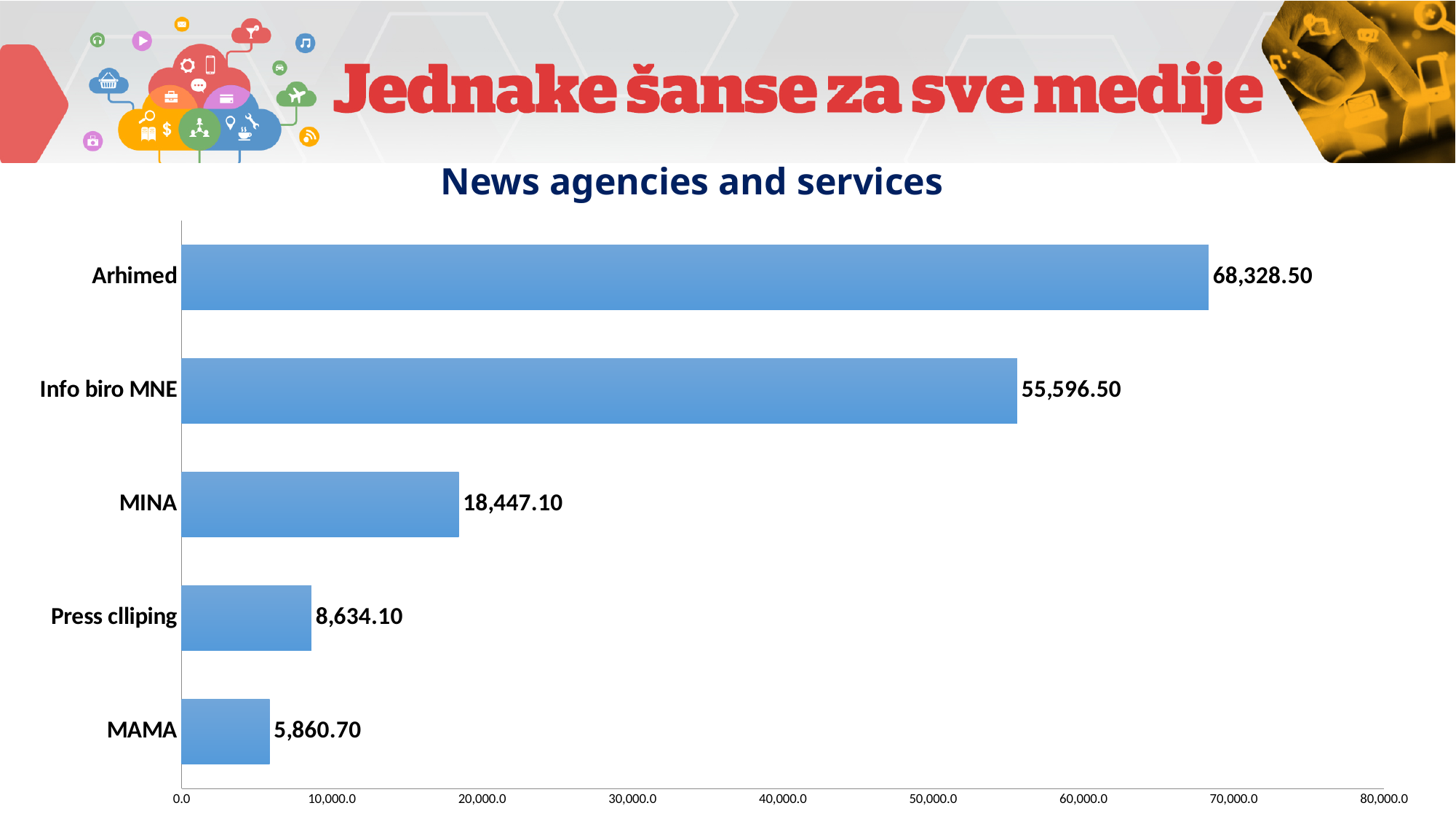
What is the value for Arhimed? 68,328.50 What kind of chart is shown on the slide? bar chart Which category has the lowest value? MAMA What is the difference between the values for Arhimed and Info biro MNE? 12,732.00 What is the value for MAMA? 5,860.70 What is the title of the chart? News agencies and services Which category has the highest value? Arhimed What is the value for MINA? 18,447.10 Which is larger, the value for MINA or the value for Press clliping? MINA Is the value for Info biro MNE greater or less than 50,000.0? greater How many categories are shown in the chart? 5 What is the difference between the values for Press clliping and MAMA? 2,773.40